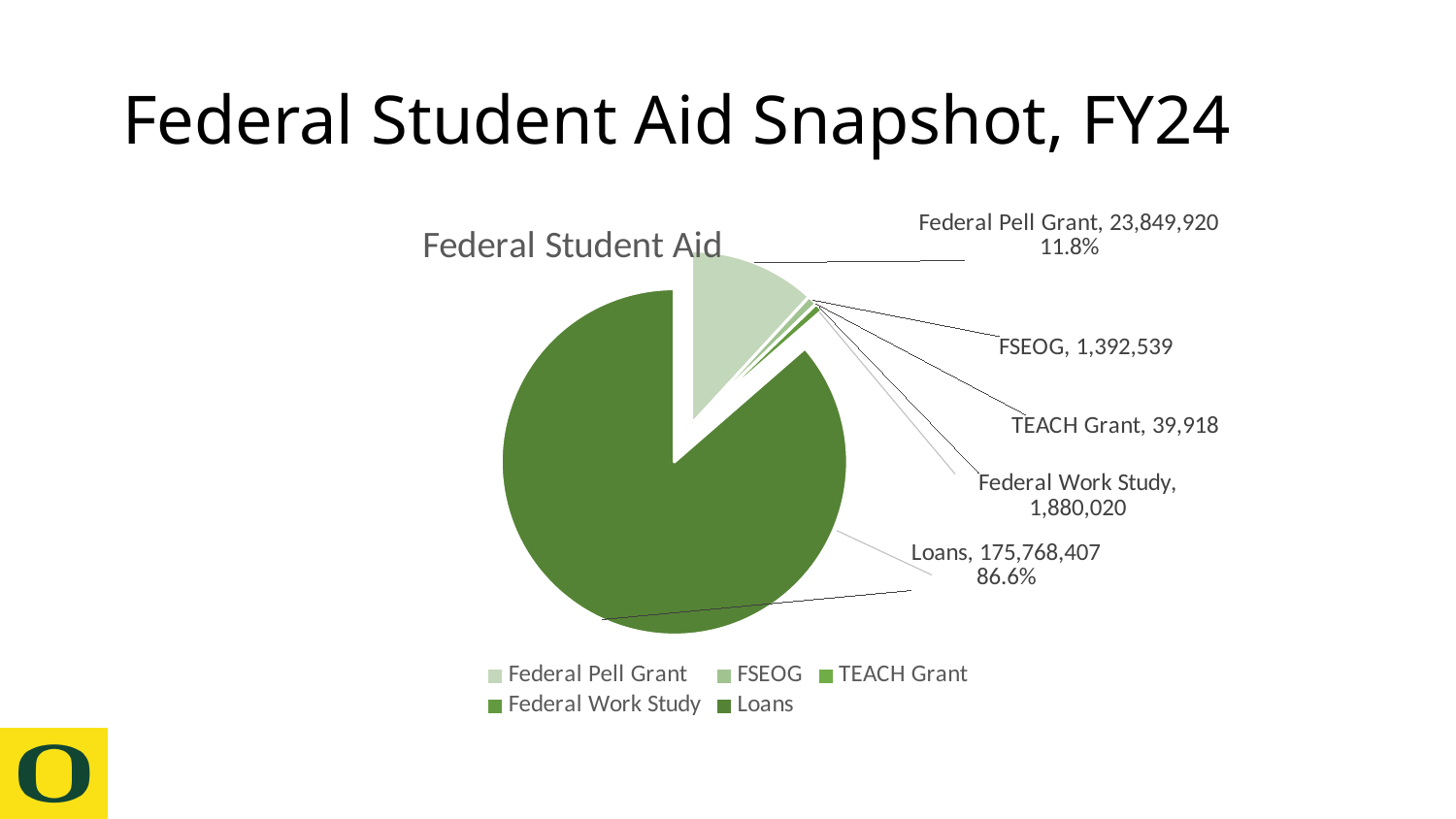
What is the value for FSEOG in the pie chart? 1,392,539 What is the value for Loans in the Federal Student Aid pie chart? 175,768,407 How many categories are shown in the pie chart? 5 What share of the pie does Loans represent? 86.6% What is the difference between the Loans value and the Federal Pell Grant value? 151,918,487 Which category has the smallest slice in the pie chart? TEACH Grant What is the value for Federal Work Study in the pie chart? 1,880,020 What is the value for TEACH Grant in the pie chart? 39,918 What is the value for Federal Pell Grant in the pie chart? 23,849,920 What share of the pie does Federal Pell Grant represent? 11.8% Which is larger, FSEOG or Federal Work Study? Federal Work Study Which category has the largest slice in the pie chart? Loans